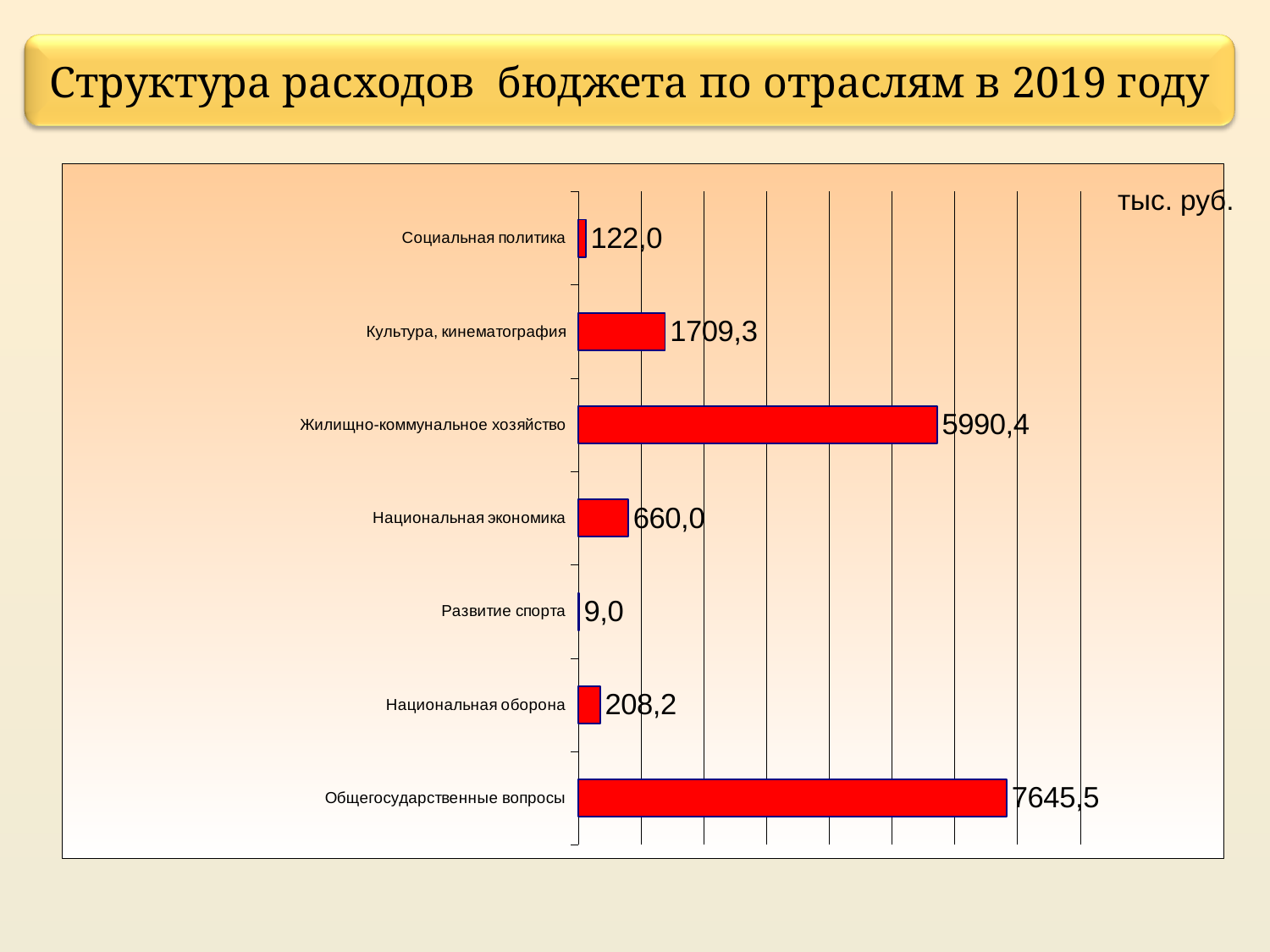
Which category has the highest value? Общегосударственные вопросы What kind of chart is shown on the slide? Bar chart How many categories are shown in the chart? 7 What is the value for Общегосударственные вопросы? 7645,5 Which category has the lowest value? Развитие спорта What unit is indicated in the top right corner of the chart? тыс. руб. What is the title of the slide? Структура расходов бюджета по отраслям в 2019 году What is the difference between Общегосударственные вопросы and Жилищно-коммунальное хозяйство? 1655,1 Which is larger, Национальная экономика or Национальная оборона? Национальная экономика What is the value for Жилищно-коммунальное хозяйство? 5990,4 What is the value for Культура, кинематография? 1709,3 What is the value for Развитие спорта? 9,0